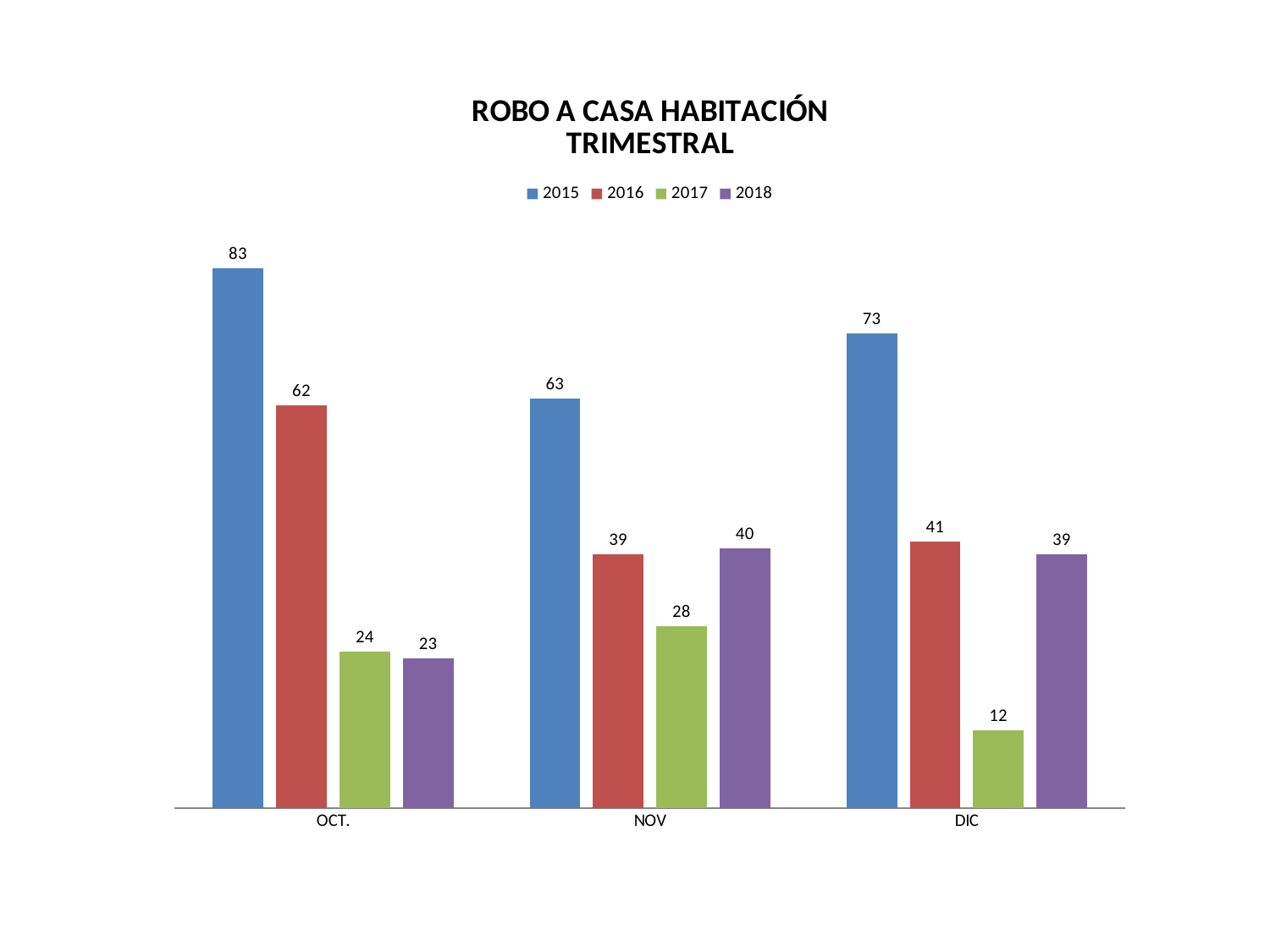
Do the values for 2015 rise or fall from OCT. to NOV? fall Which is larger in NOV: the value for 2016 or the value for 2018? 2018 What is the value for 2015 in OCT.? 83 What kind of chart is shown? bar chart Which month has the lowest value for 2017? DIC How many series does the legend list? 4 What is the title of the chart? ROBO A CASA HABITACIÓN TRIMESTRAL What is the value for 2018 in NOV? 40 Which month has the highest value for 2015? OCT. What is the value for 2017 in DIC? 12 How many months are shown on the x axis? 3 What is the difference between the 2015 and 2016 values in OCT.? 21